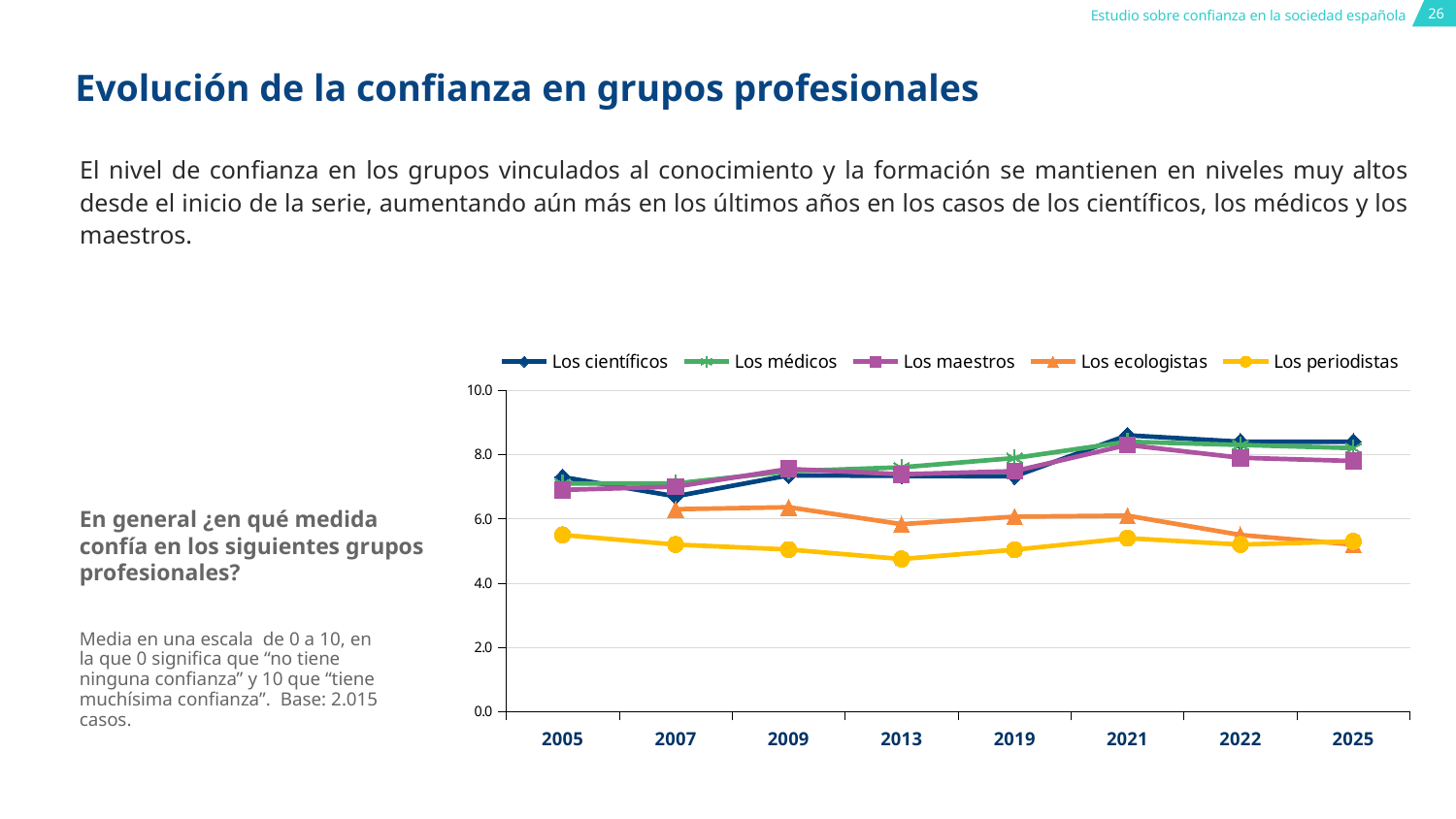
Which series has the highest value in 2021? Los científicos In 2009, which is larger: the value for Los ecologistas or the value for Los periodistas? Los ecologistas Which series has the lowest value in 2013? Los periodistas How many years are shown on the x axis of the chart? 8 How many series does the chart legend list? 5 Does the value for Los periodistas rise or fall from 2005 to 2013? fall What kind of chart is shown on the slide? Line chart Is the value for Los periodistas in 2013 greater or less than 6.0? less What is the title of the slide containing the chart? Evolución de la confianza en grupos profesionales Is the value for Los científicos in 2021 greater or less than 8.0? greater In 2021, which is larger: the value for Los científicos or the value for Los periodistas? Los científicos